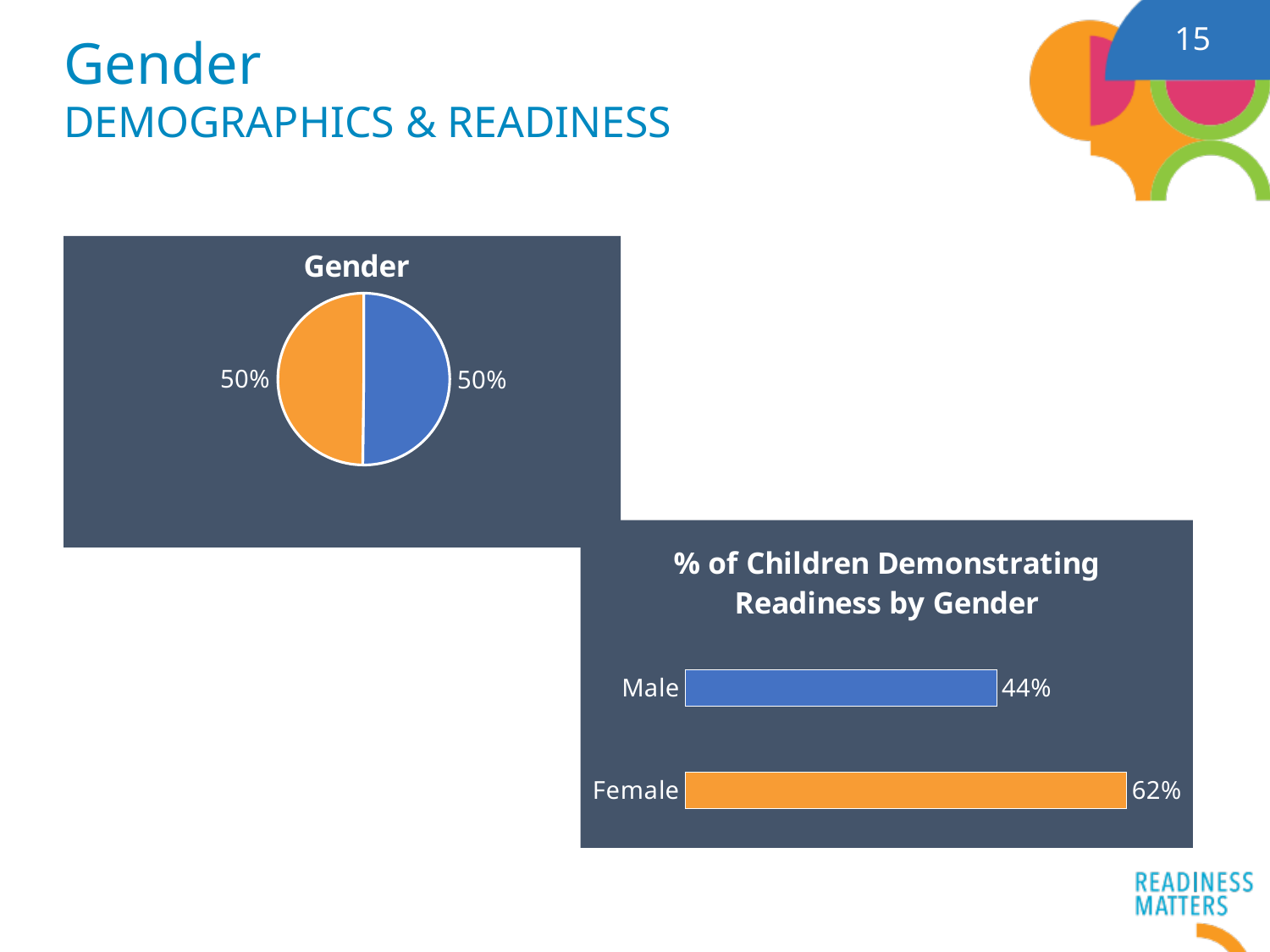
In the '% of Children Demonstrating Readiness by Gender' chart, what colour is the Female bar? Orange In the '% of Children Demonstrating Readiness by Gender' chart, which category has the highest value? Female In the '% of Children Demonstrating Readiness by Gender' chart, what is the difference between the Female and Male values? 18% In the 'Gender' pie chart, what share does each slice show? 50% What kind of chart is the '% of Children Demonstrating Readiness by Gender' chart? Bar chart In the '% of Children Demonstrating Readiness by Gender' chart, which category has the lowest value? Male How many categories are shown in the '% of Children Demonstrating Readiness by Gender' chart? 2 What kind of chart is the 'Gender' chart on the left of the slide? Pie chart In the '% of Children Demonstrating Readiness by Gender' chart, is the value for Male or Female larger? Female In the '% of Children Demonstrating Readiness by Gender' chart, what is the value for Male? 44% How many slices does the 'Gender' pie chart have? 2 In the '% of Children Demonstrating Readiness by Gender' chart, what is the value for Female? 62%